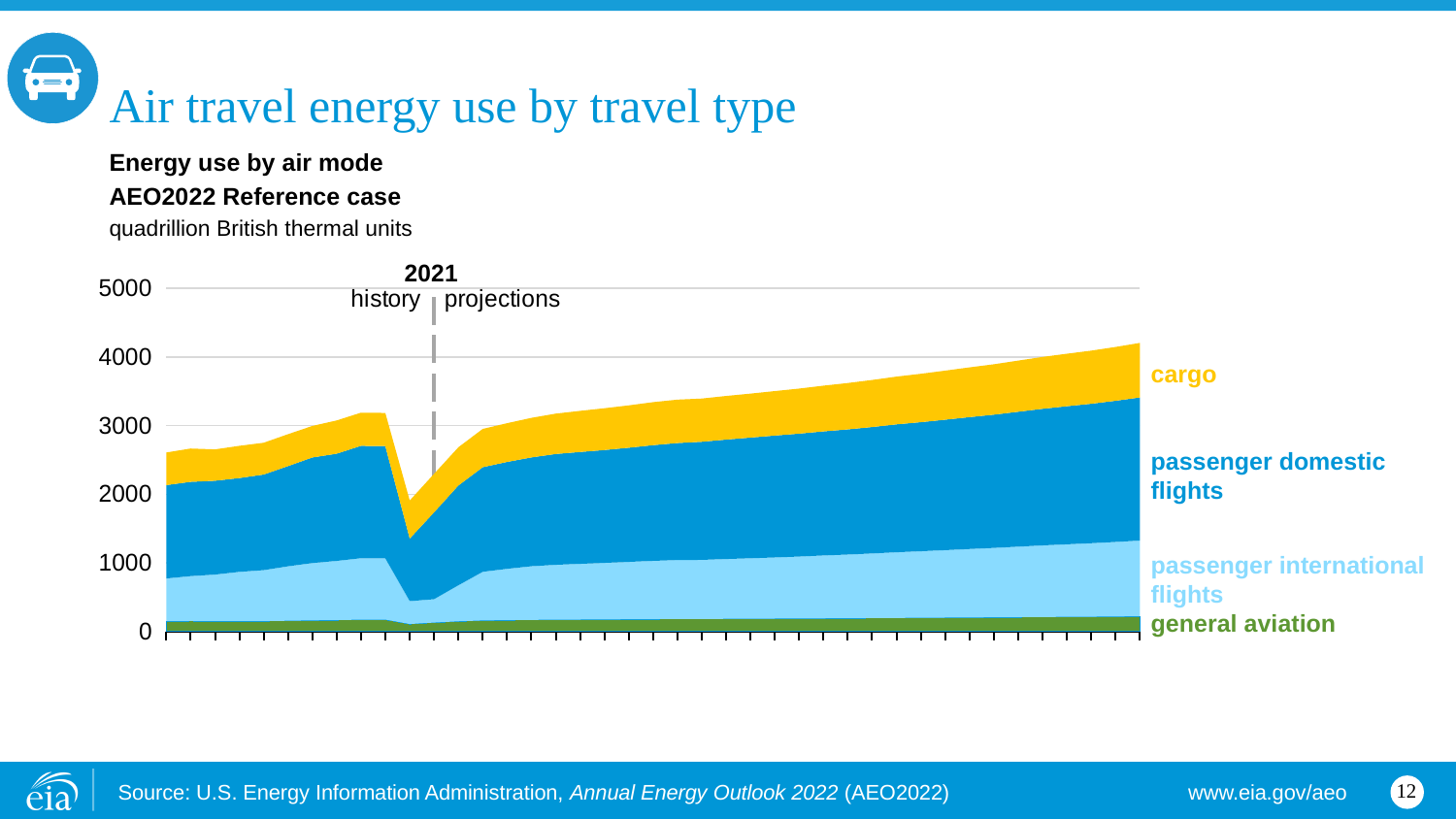
Which travel type accounts for the smallest share of air travel energy use? general aviation Which series is shown at the top of the stacked area chart? cargo What year separates history from projections in the chart? 2021 Is the total air travel energy use at the start of the history period greater or less than 2000? greater Is the total air travel energy use at the end of the projection period greater or less than 4000? greater How many travel types (series) are shown in the chart? 4 What unit is the energy use measured in on the chart? quadrillion British thermal units What kind of chart is shown on the slide? stacked area chart Is the total air travel energy use at the 2021 dip greater or less than 3000? less Does total air travel energy use rise or fall over the projection period after 2021? rise Which travel type accounts for the largest share of air travel energy use? passenger domestic flights Which uses more energy, passenger domestic flights or passenger international flights? passenger domestic flights